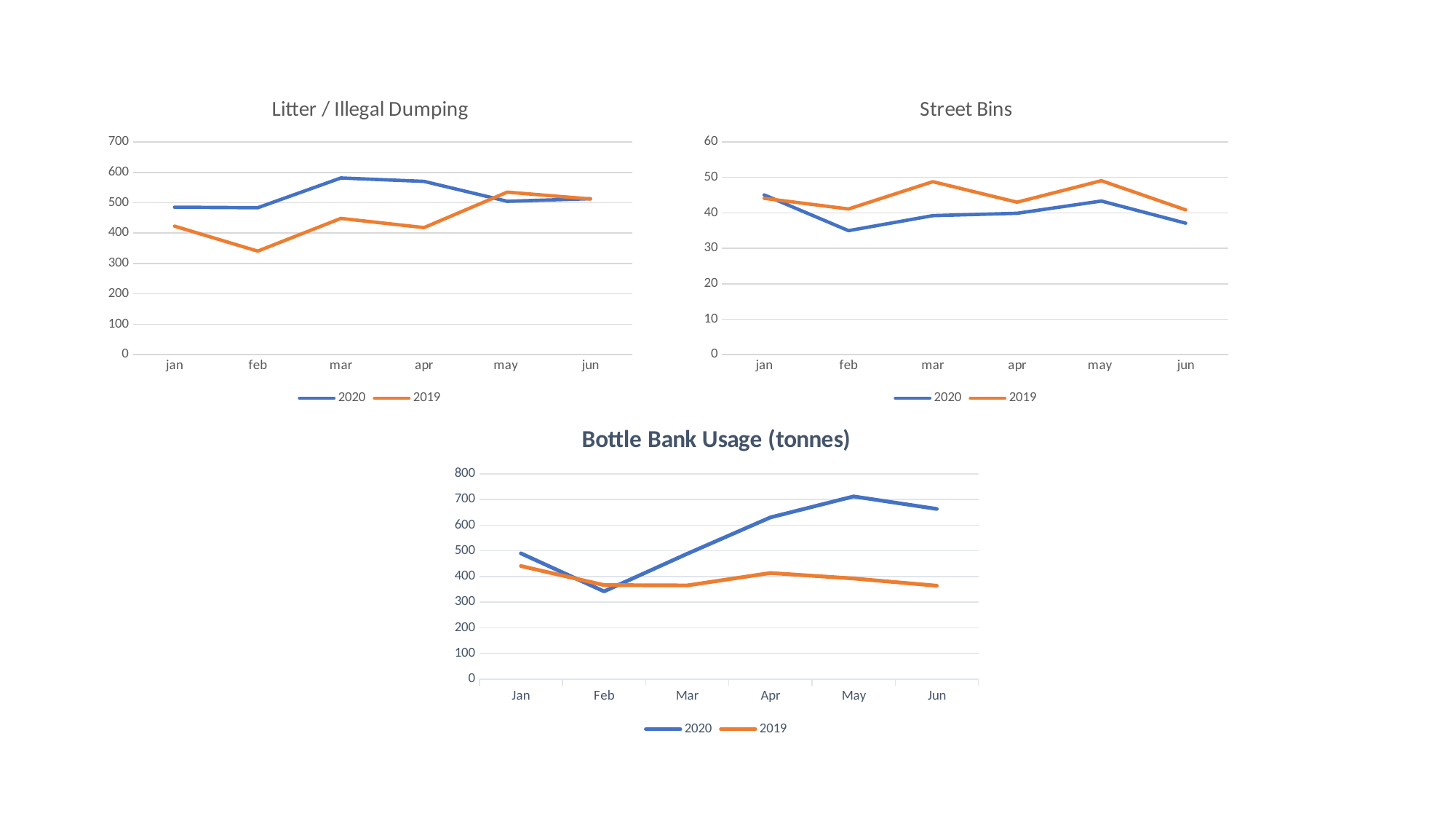
How many series does the legend of the Street Bins chart list? 2 In the Street Bins chart, which series is higher in may, 2020 or 2019? 2019 In the Bottle Bank Usage (tonnes) chart, which month has the highest 2020 value? May How many months are plotted on the x axis of the Bottle Bank Usage (tonnes) chart? 6 In the Litter / Illegal Dumping chart, is the 2019 value for feb greater or less than 400? less In the Bottle Bank Usage (tonnes) chart, does the 2020 line rise or fall from Feb to May? rises In the Street Bins chart, is the 2020 value for feb greater or less than 40? less In the Street Bins chart, which month has the lowest 2020 value? feb In the Litter / Illegal Dumping chart, which series is higher in mar, 2020 or 2019? 2020 In the Litter / Illegal Dumping chart, which month has the lowest 2019 value? feb What kind of chart is the Litter / Illegal Dumping chart? line chart In the Bottle Bank Usage (tonnes) chart, is the 2020 value for Feb greater or less than 400? less